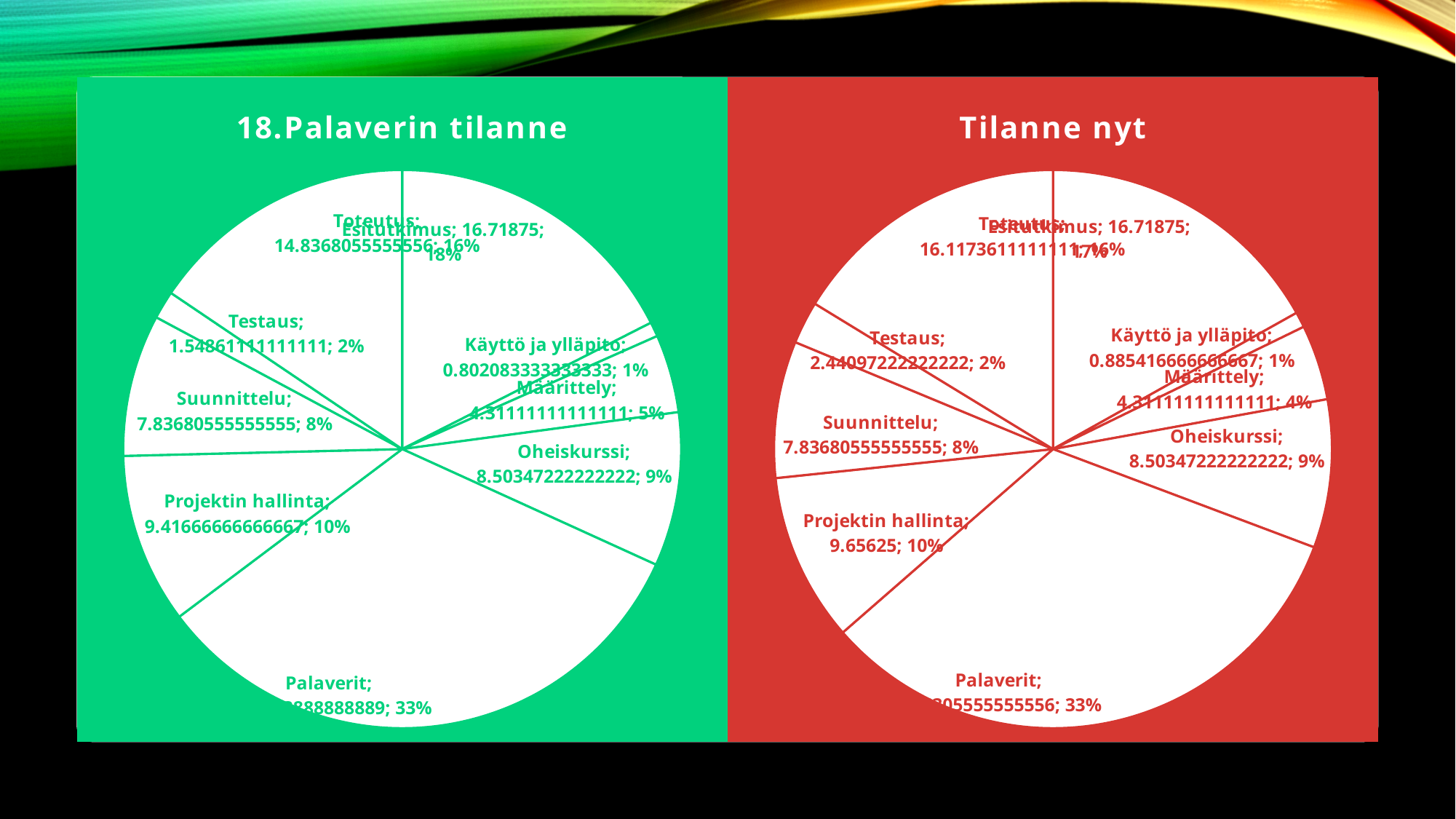
What type of chart is shown under the title "18.Palaverin tilanne"? pie chart In the "18.Palaverin tilanne" chart, which category has the smallest slice? Käyttö ja ylläpito In the "18.Palaverin tilanne" chart, what value is shown for Testaus? 1.54861111111111 In the "18.Palaverin tilanne" chart, what value is shown for Projektin hallinta? 9.41666666666667 How many categories are shown in the "Tilanne nyt" pie chart? 9 In the "Tilanne nyt" chart, what percentage share does Oheiskurssi have? 9% In the "Tilanne nyt" chart, which category has the largest slice? Palaverit In the "18.Palaverin tilanne" chart, what percentage share does Palaverit have? 33% In the "Tilanne nyt" chart, what value is shown for Projektin hallinta? 9.65625 In the "Tilanne nyt" chart, what value is shown for Testaus? 2.44097222222222 What is the title of the chart on the right side of the slide? Tilanne nyt In the "Tilanne nyt" chart, which is larger: the value for Suunnittelu or the value for Määrittely? Suunnittelu